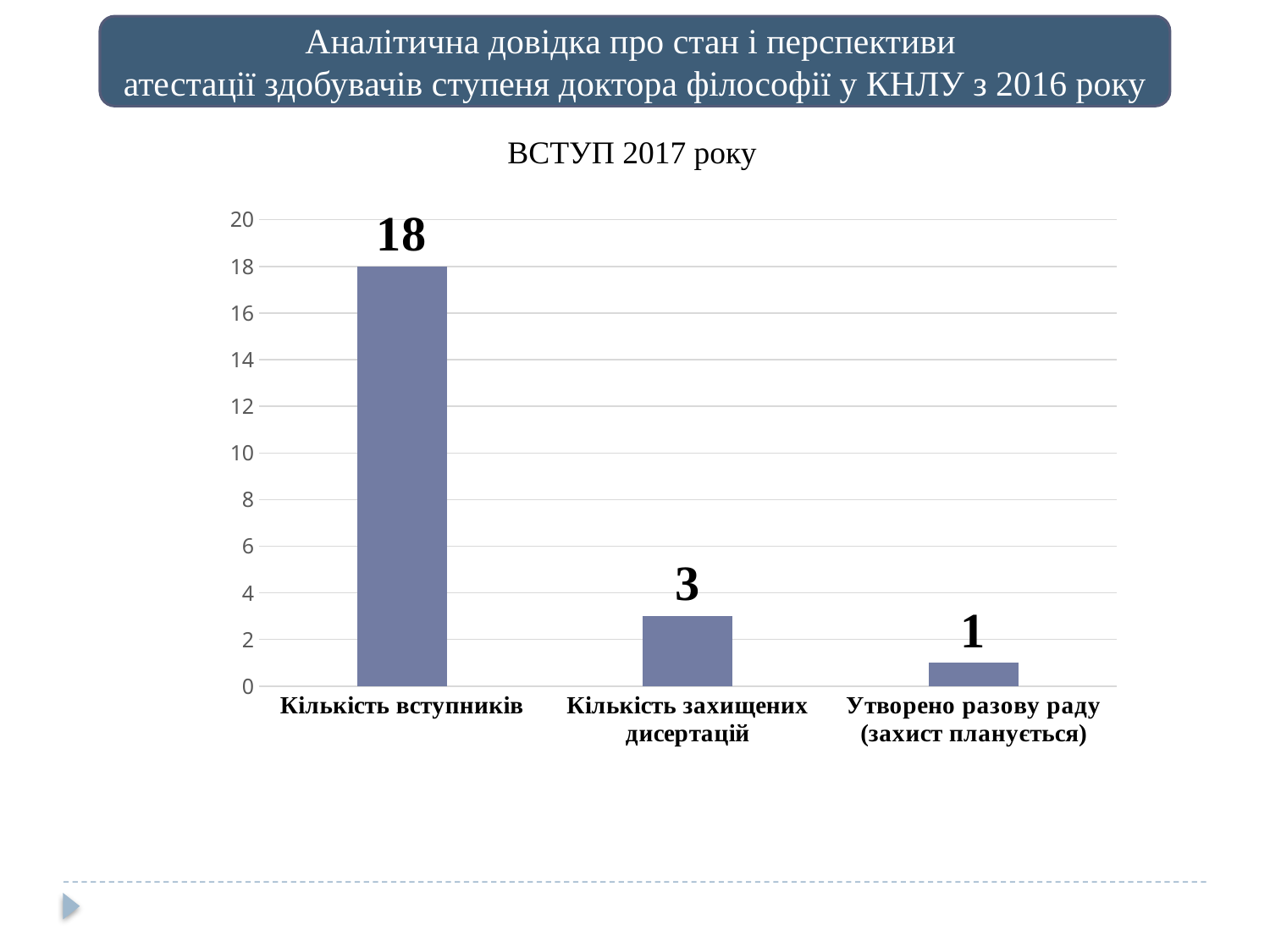
What is the difference between the values for Кількість вступників and Кількість захищених дисертацій? 15 Which is larger: the value for Кількість захищених дисертацій or the value for Утворено разову раду (захист планується)? Кількість захищених дисертацій What is the value for Кількість захищених дисертацій? 3 Which category has the lowest value? Утворено разову раду (захист планується) What is the value for Утворено разову раду (захист планується)? 1 What kind of chart is shown on the slide? bar chart How many categories are shown in the chart? 3 Is the value for Кількість вступників greater or less than 10? greater What is the value for Кількість вступників? 18 Which category has the highest value? Кількість вступників What is the title of the chart? ВСТУП 2017 року What is the difference between the values for Кількість захищених дисертацій and Утворено разову раду (захист планується)? 2